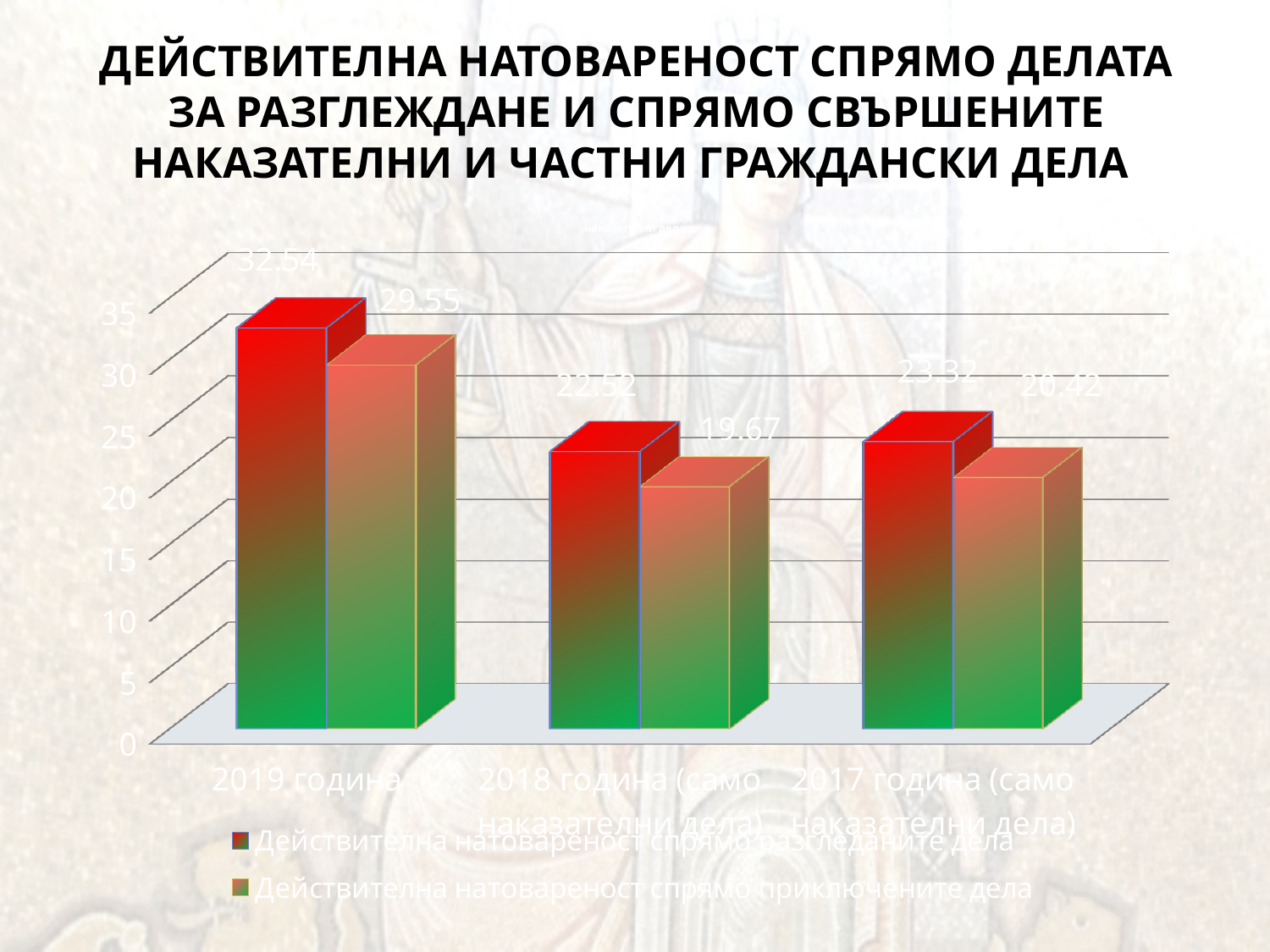
What is the value of 'Действителна натовареност спрямо разгледаните дела' for '2018 година (само наказателни дела)'? 22.52 What is the value of 'Действителна натовареност спрямо разгледаните дела' for '2019 година'? 32.54 What is the value of 'Действителна натовареност спрямо приключените дела' for '2019 година'? 29.55 What is the value of 'Действителна натовареност спрямо приключените дела' for '2017 година (само наказателни дела)'? 20.42 Is the value of 'Действителна натовареност спрямо приключените дела' for '2018 година (само наказателни дела)' greater or less than 20? less How many series does the legend list? 2 Which category has the lowest value for 'Действителна натовареност спрямо приключените дела'? 2018 година (само наказателни дела) What kind of chart is shown on the slide? bar chart Which is larger: 'Действителна натовареност спрямо разгледаните дела' for '2017 година (само наказателни дела)' or for '2018 година (само наказателни дела)'? 2017 година (само наказателни дела) Which category has the highest value for 'Действителна натовареност спрямо разгледаните дела'? 2019 година How many categories are shown on the x axis? 3 What is the difference between the two series values for '2019 година'? 2.99